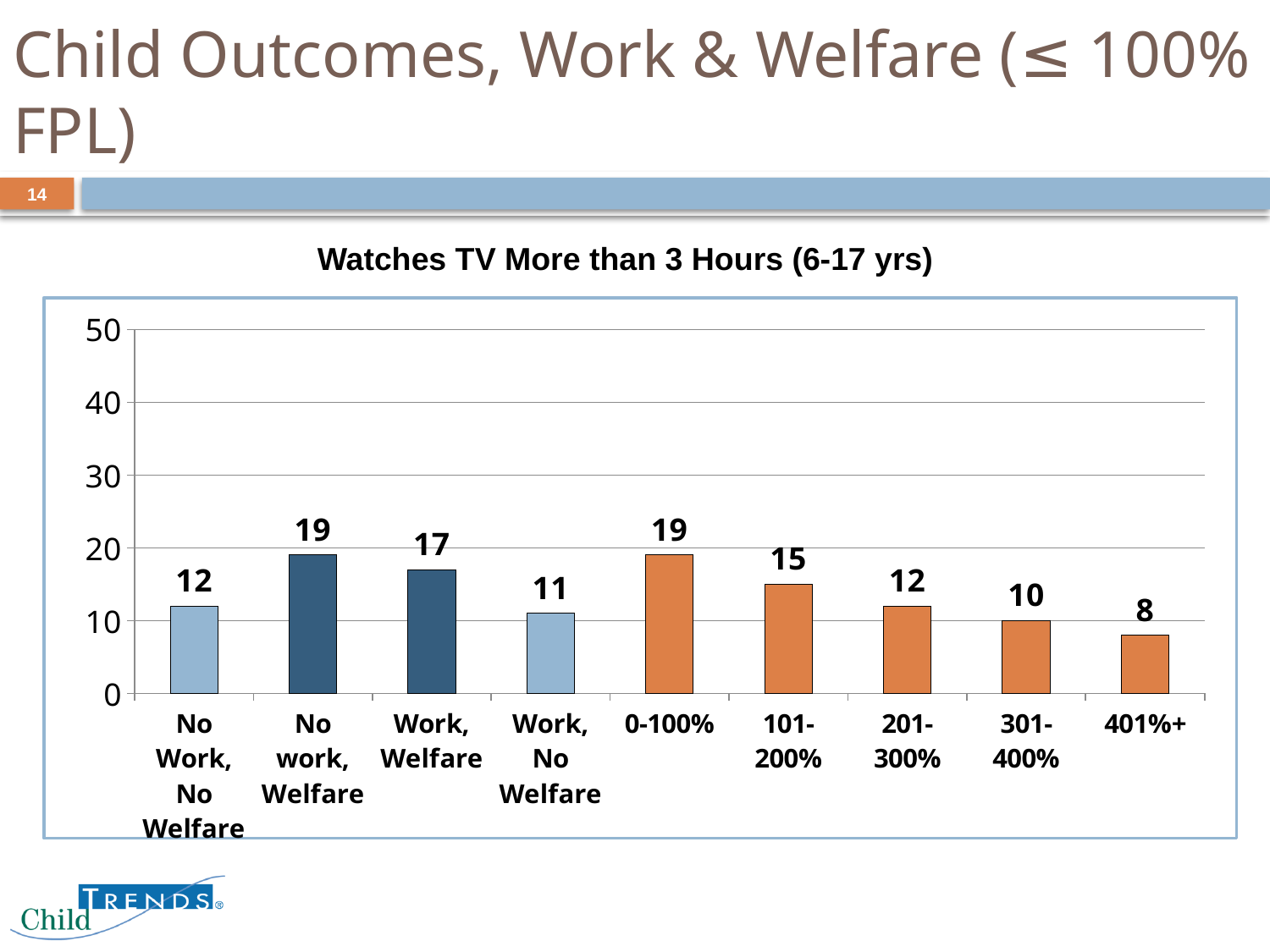
How many categories are shown on the x axis of the chart? 9 What is the value for 'No Work, No Welfare' in the chart? 12 What is the value for '401%+' in the chart? 8 What kind of chart is shown on the slide? bar chart What is the value for 'Work, Welfare' in the 'Watches TV More than 3 Hours (6-17 yrs)' chart? 17 Which is larger: the value for '101-200%' or the value for '201-300%'? 101-200% Which category has the lowest value in the chart? 401%+ What is the highest value shown on the y axis of the chart? 50 Do the values rise or fall across the income categories from '0-100%' to '401%+'? fall Is the value for '0-100%' greater or less than 10? greater What is the difference between the values for 'No work, Welfare' and 'Work, No Welfare'? 8 What is the title of the chart? Watches TV More than 3 Hours (6-17 yrs)